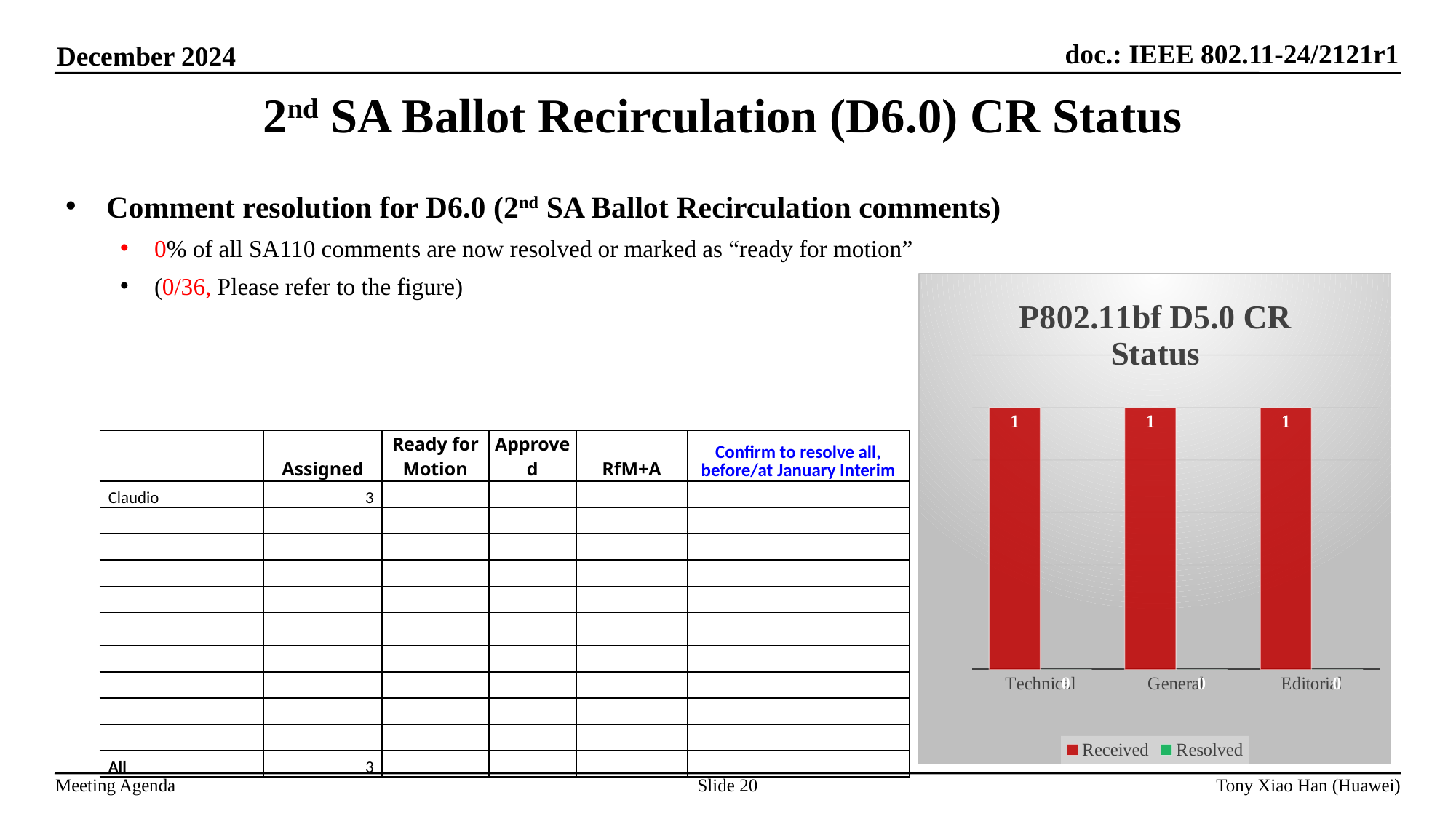
What is the difference between the Received and Resolved values for Technical? 1 What are the series names listed in the chart legend? Received, Resolved How many categories are shown on the x axis of the chart? 3 What is the Resolved value for Technical? 0 What is the Received value for Technical? 1 What is the title of the chart on the slide? P802.11bf D5.0 CR Status What is the Received value for Editorial? 1 How many series does the chart legend list? 2 What is the Received value for General? 1 What kind of chart is shown on the slide? bar chart What is the Resolved value for Editorial? 0 For General, which is larger, Received or Resolved? Received